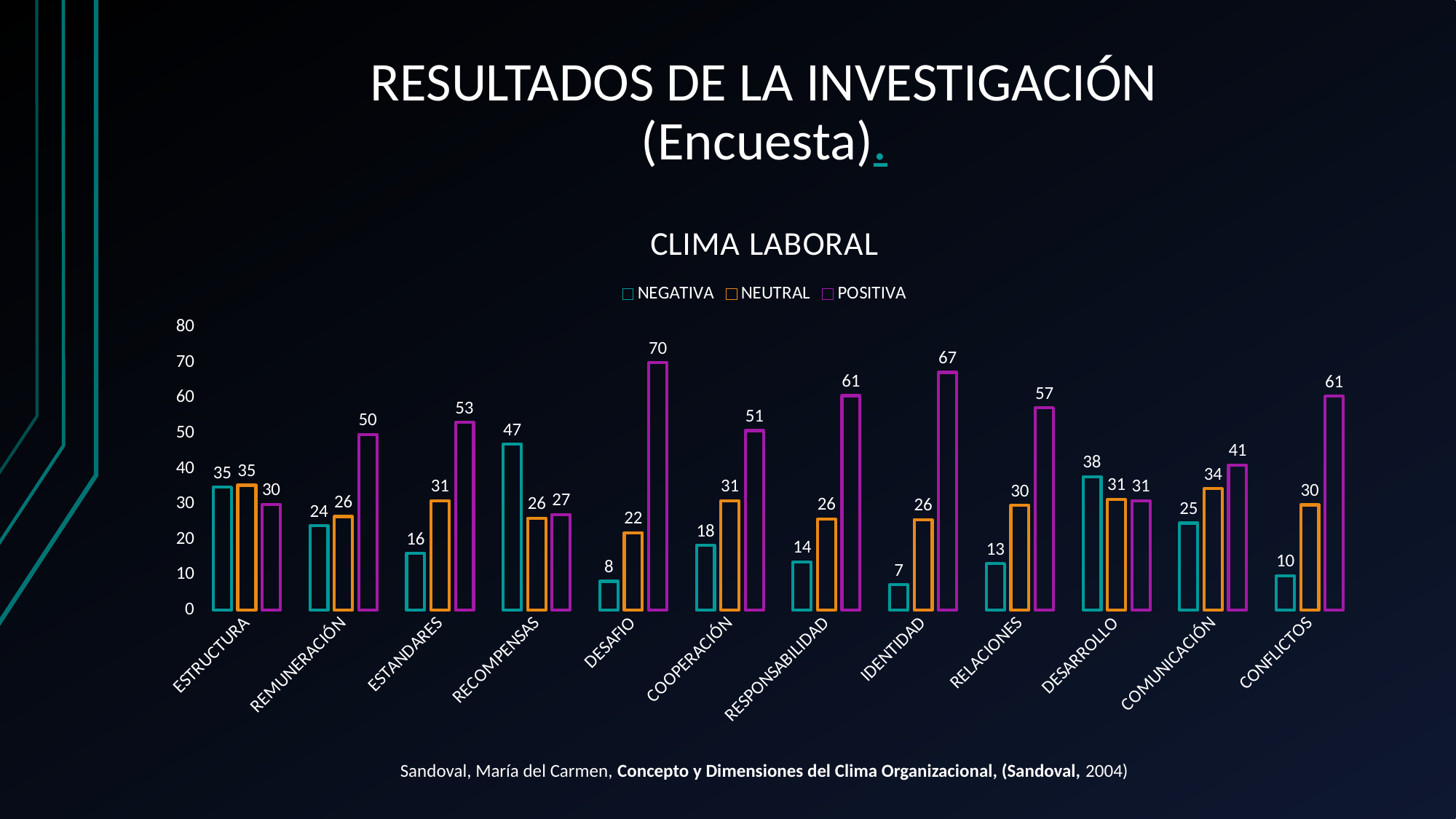
Which category has the highest POSITIVA value? DESAFIO Which series is drawn in orange? NEUTRAL What is the NEUTRAL value for COMUNICACIÓN? 34 Which category has the lowest NEGATIVA value? IDENTIDAD What is the NEGATIVA value for RECOMPENSAS? 47 What is the title of the chart? CLIMA LABORAL What is the difference between the POSITIVA and NEGATIVA values for IDENTIDAD? 60 How many series does the legend list? 3 Which is larger for ESTANDARES: the NEUTRAL value or the NEGATIVA value? NEUTRAL How many categories are shown on the x axis? 12 What is the POSITIVA value for DESAFIO? 70 What kind of chart is shown? bar chart